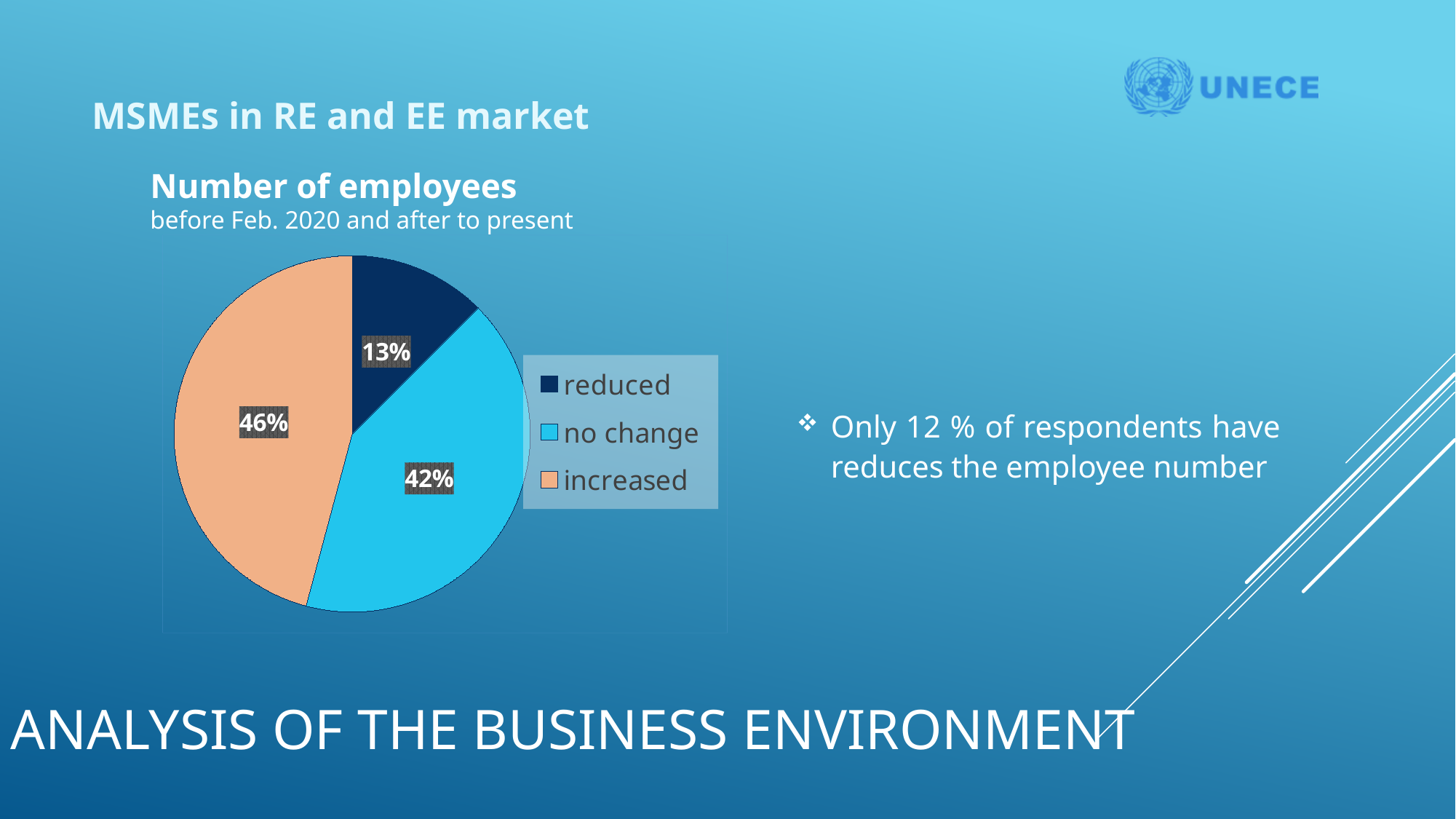
What share of the pie is labelled "reduced"? 13% Which category has the largest slice of the pie? increased What is the difference in percentage points between the "no change" and "reduced" slices? 29 Which colour represents the "increased" category in the legend? orange What type of chart is shown on the slide? pie chart Which slice is larger, "no change" or "reduced"? no change What share of the pie is labelled "increased"? 46% How many categories does the pie chart have? 3 What is the difference in percentage points between the "increased" and "no change" slices? 4 Which category has the smallest slice of the pie? reduced What share of the pie is labelled "no change"? 42% What is the title of the pie chart? Number of employees